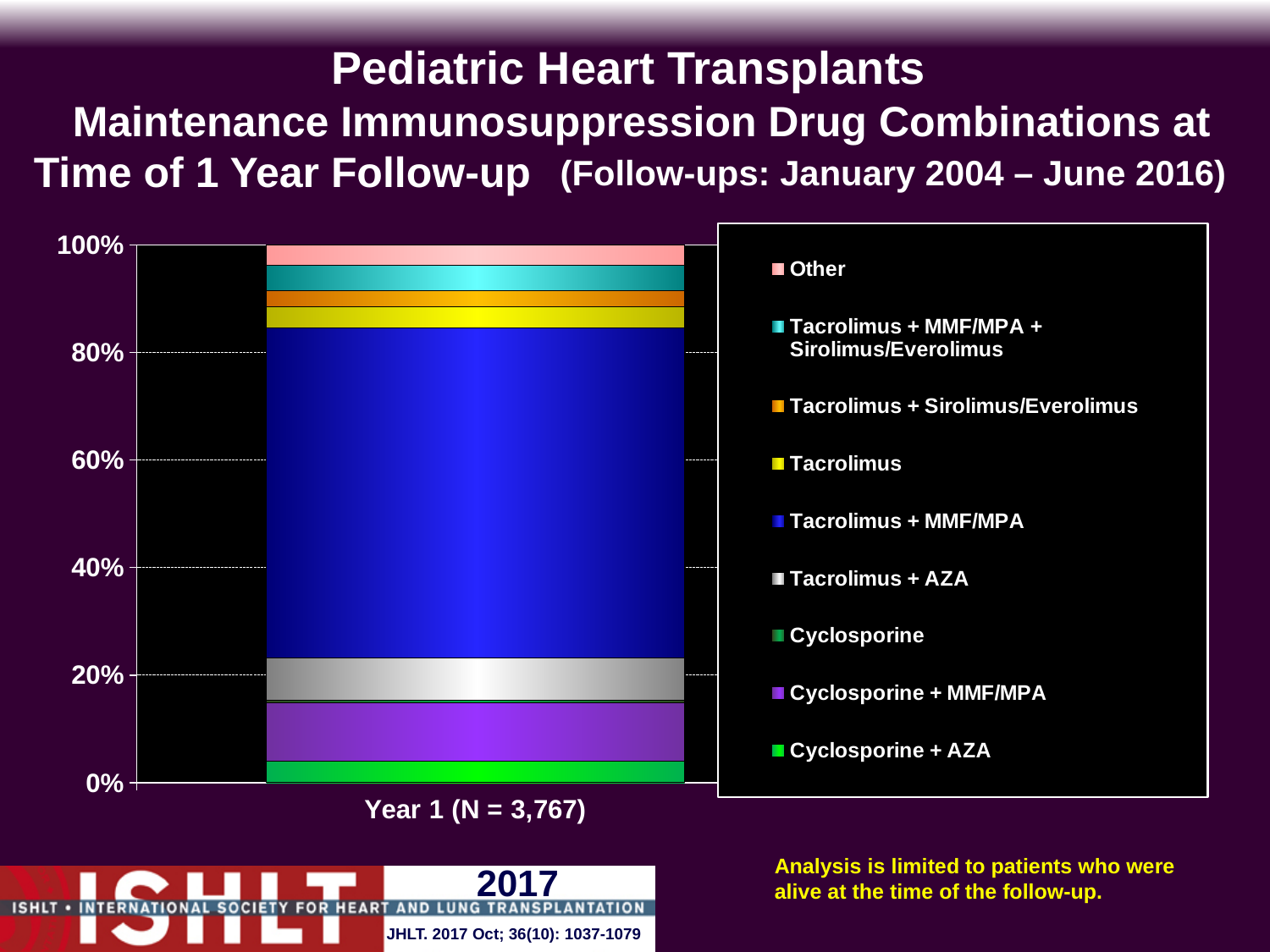
How many series does the legend list? 9 Is the combined share of the three Cyclosporine-based combinations (the bottom three segments) greater or less than 20%? less Which legend entry is listed first (at the top) in the legend? Other Which segment is larger in the Year 1 bar: Cyclosporine + MMF/MPA or Cyclosporine + AZA? Cyclosporine + MMF/MPA What is the label of the single category on the x axis? Year 1 (N = 3,767) Which segment is larger in the Year 1 bar: Tacrolimus + AZA or Other? Tacrolimus + AZA Which drug combination occupies the largest segment of the Year 1 bar? Tacrolimus + MMF/MPA Which segment is larger in the Year 1 bar: Tacrolimus + MMF/MPA or Cyclosporine + MMF/MPA? Tacrolimus + MMF/MPA Is the share of Tacrolimus + MMF/MPA in the Year 1 bar greater or less than 40%? greater How many bars (categories) are plotted on the x axis? 1 What kind of chart is shown on the slide? stacked bar chart